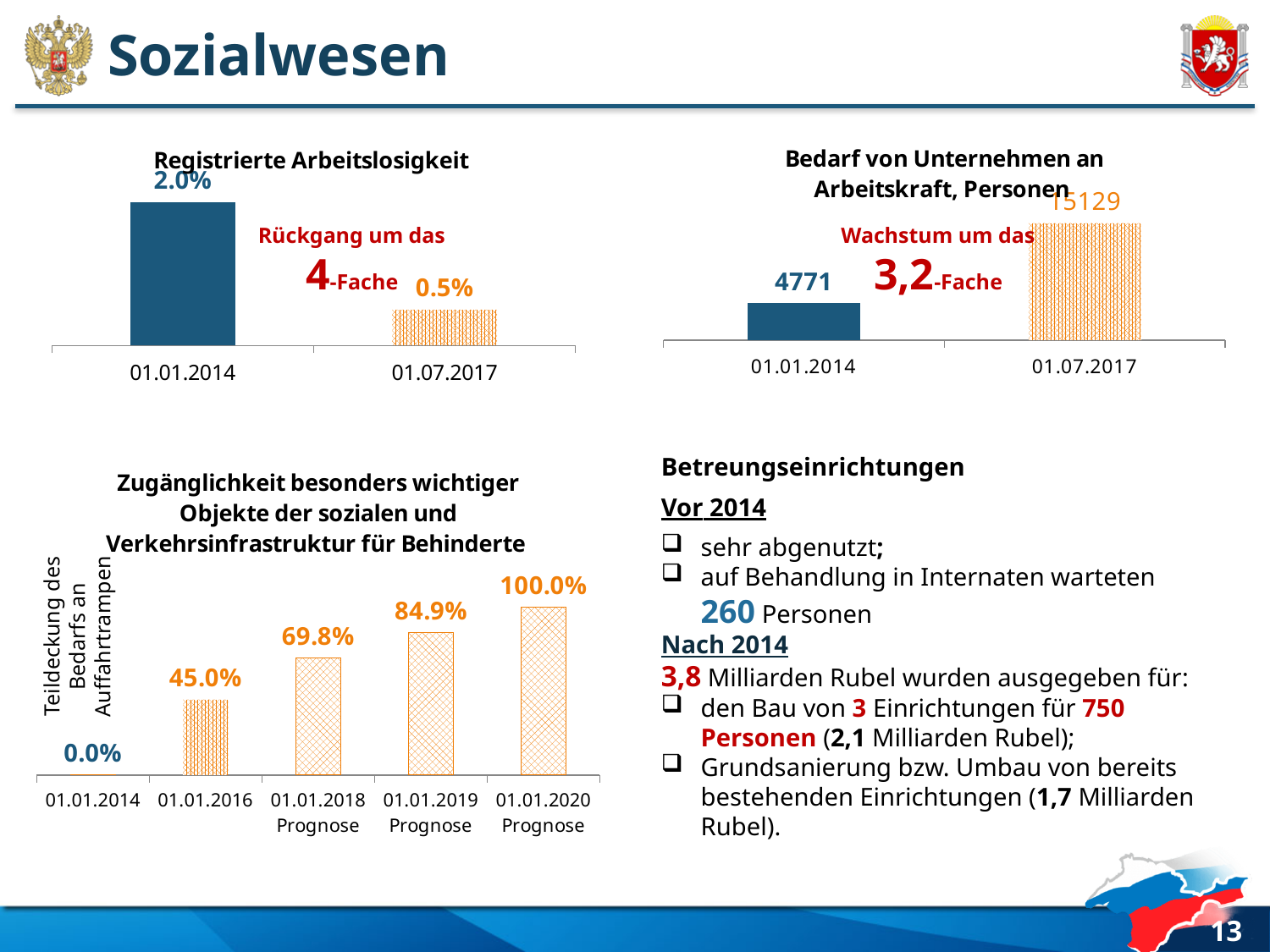
What kind of chart is 'Registrierte Arbeitslosigkeit'? bar chart In the chart 'Registrierte Arbeitslosigkeit', what is the value for 01.07.2017? 0.5% In the chart 'Bedarf von Unternehmen an Arbeitskraft, Personen', which date has the higher value? 01.07.2017 In the chart 'Registrierte Arbeitslosigkeit', what is the value for 01.01.2014? 2.0% In the chart 'Bedarf von Unternehmen an Arbeitskraft, Personen', by how much does the 01.07.2017 value exceed the 01.01.2014 value? 10358 In the chart 'Zugänglichkeit besonders wichtiger Objekte der sozialen und Verkehrsinfrastruktur für Behinderte', what is the value for 01.01.2018 Prognose? 69.8% In the chart 'Bedarf von Unternehmen an Arbeitskraft, Personen', what is the value for 01.07.2017? 15129 In the chart 'Zugänglichkeit besonders wichtiger Objekte der sozialen und Verkehrsinfrastruktur für Behinderte', which category has the lowest value? 01.01.2014 In the chart 'Bedarf von Unternehmen an Arbeitskraft, Personen', what is the value for 01.01.2014? 4771 In the chart 'Zugänglichkeit besonders wichtiger Objekte der sozialen und Verkehrsinfrastruktur für Behinderte', how many categories are shown on the x axis? 5 In the chart 'Registrierte Arbeitslosigkeit', what is the difference between the 01.01.2014 and 01.07.2017 values? 1.5% In the chart 'Zugänglichkeit besonders wichtiger Objekte der sozialen und Verkehrsinfrastruktur für Behinderte', do the values rise or fall from left to right? rise